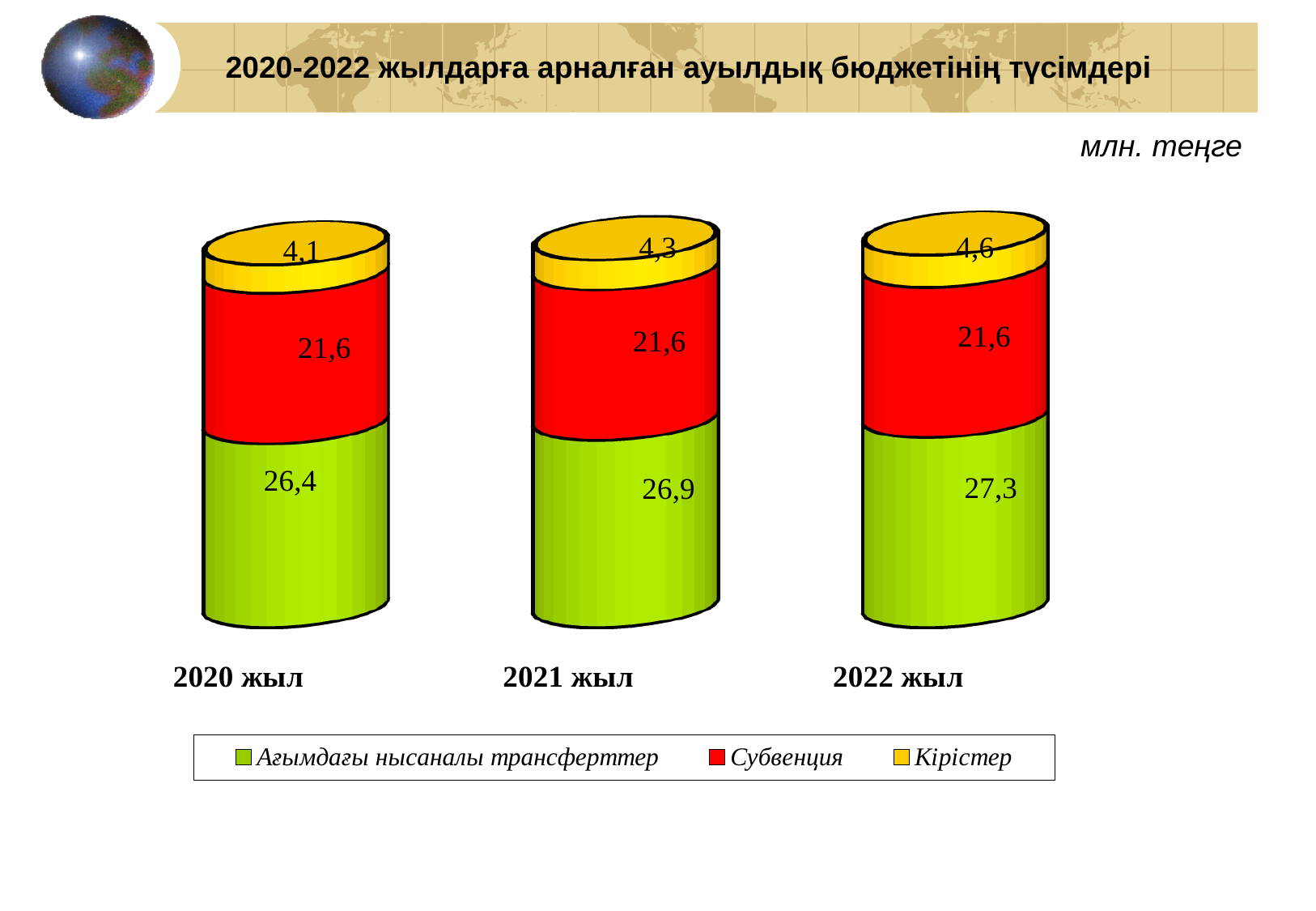
What is the value of Кірістер for 2022 жыл? 4,6 Which is larger: Кірістер in 2021 жыл or Кірістер in 2022 жыл? 2022 жыл What is the total of the stacked bar for 2020 жыл? 52,1 In which year is Ағымдағы нысаналы трансферттер highest? 2022 жыл What is the value of Субвенция for 2021 жыл? 21,6 What is the difference between Ағымдағы нысаналы трансферттер in 2022 жыл and 2020 жыл? 0,9 What is the total of the stacked bar for 2022 жыл? 53,5 How many years (categories) are shown in the chart? 3 What kind of chart is shown on the slide? Stacked bar chart In which year is Кірістер lowest? 2020 жыл How many series does the legend list? 3 What is the value of Ағымдағы нысаналы трансферттер for 2020 жыл? 26,4